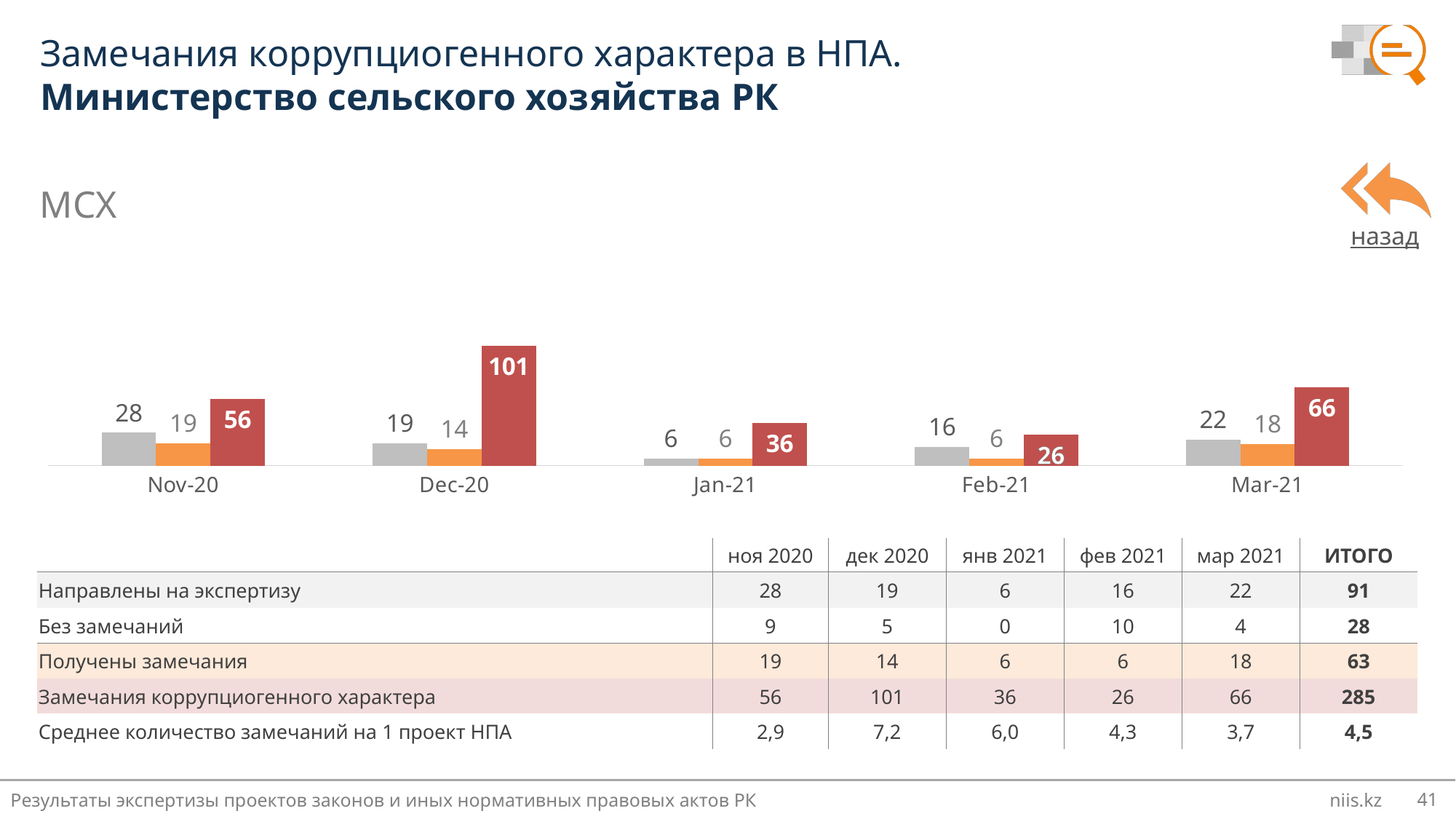
In which month is the red bar (Замечания коррупциогенного характера) highest? Dec-20 How many bars are shown for each month in the chart? 3 Which is larger: the red bar for Mar-21 or the red bar for Jan-21? Mar-21 In which month is the red bar (Замечания коррупциогенного характера) lowest? Feb-21 What is the value of the red bar for Dec-20? 101 How many months (categories) are shown on the x axis of the chart? 5 What kind of chart is shown on the slide? bar chart What is the difference between the red bar values for Dec-20 and Nov-20? 45 In which month is the grey bar (Направлены на экспертизу) lowest? Jan-21 Does the red bar value rise or fall from Dec-20 to Jan-21? fall What is the value of the grey bar for Nov-20? 28 What is the value of the orange bar for Mar-21? 18